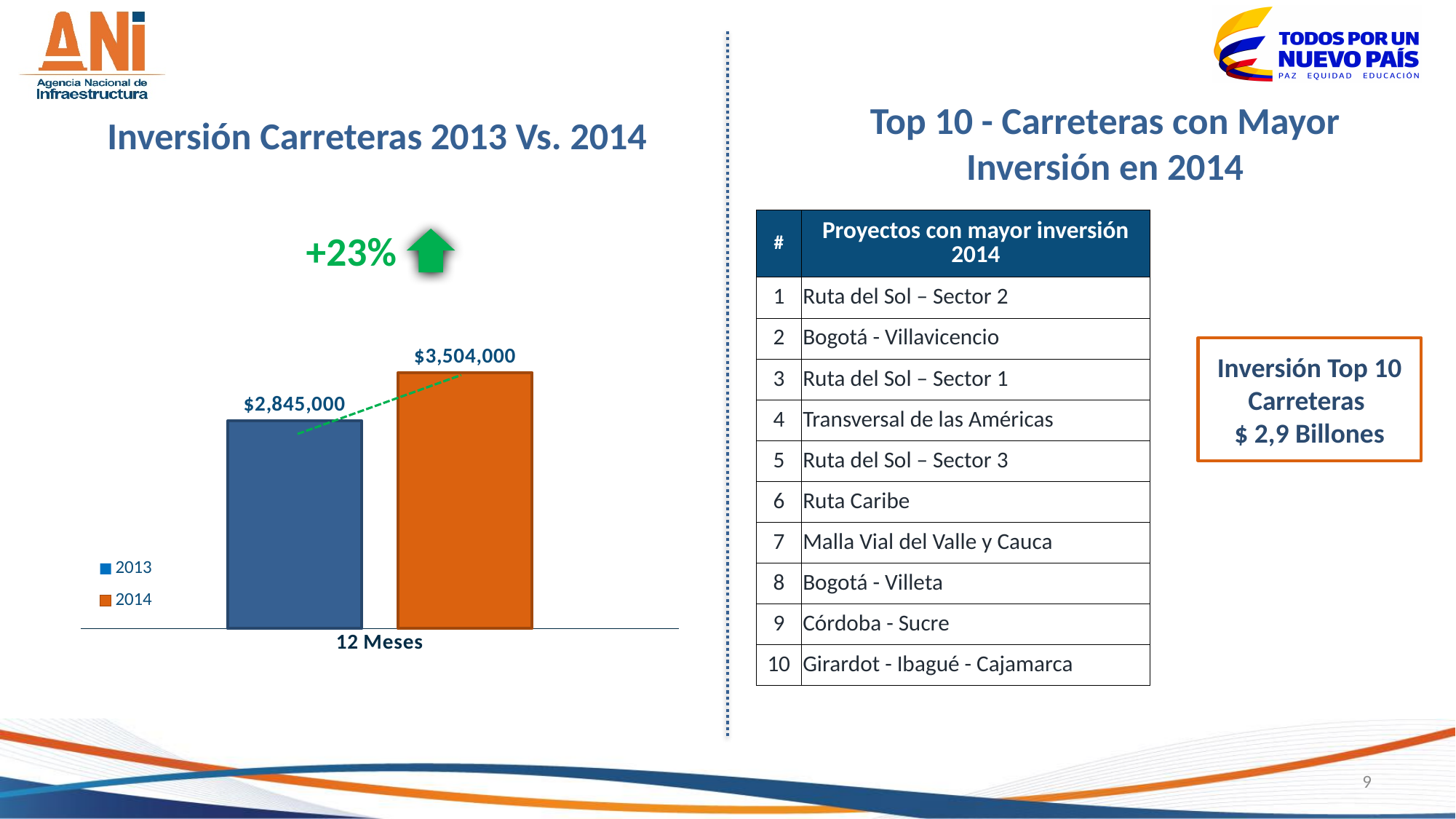
Does the investment value rise or fall from 2013 to 2014? Rise Which series has the highest value in the chart? 2014 What is the value for 2014 in the chart? $3,504,000 How many series does the chart legend list? 2 What is the difference between the 2014 value and the 2013 value? $659,000 What percentage change is annotated above the chart? +23% What is the title of the chart? Inversión Carreteras 2013 Vs. 2014 What is the category label shown on the x axis of the chart? 12 Meses Which series has the higher value, 2013 or 2014? 2014 What is the value for 2013 in the chart? $2,845,000 Which series has the lowest value in the chart? 2013 What kind of chart is shown on the slide? Bar chart